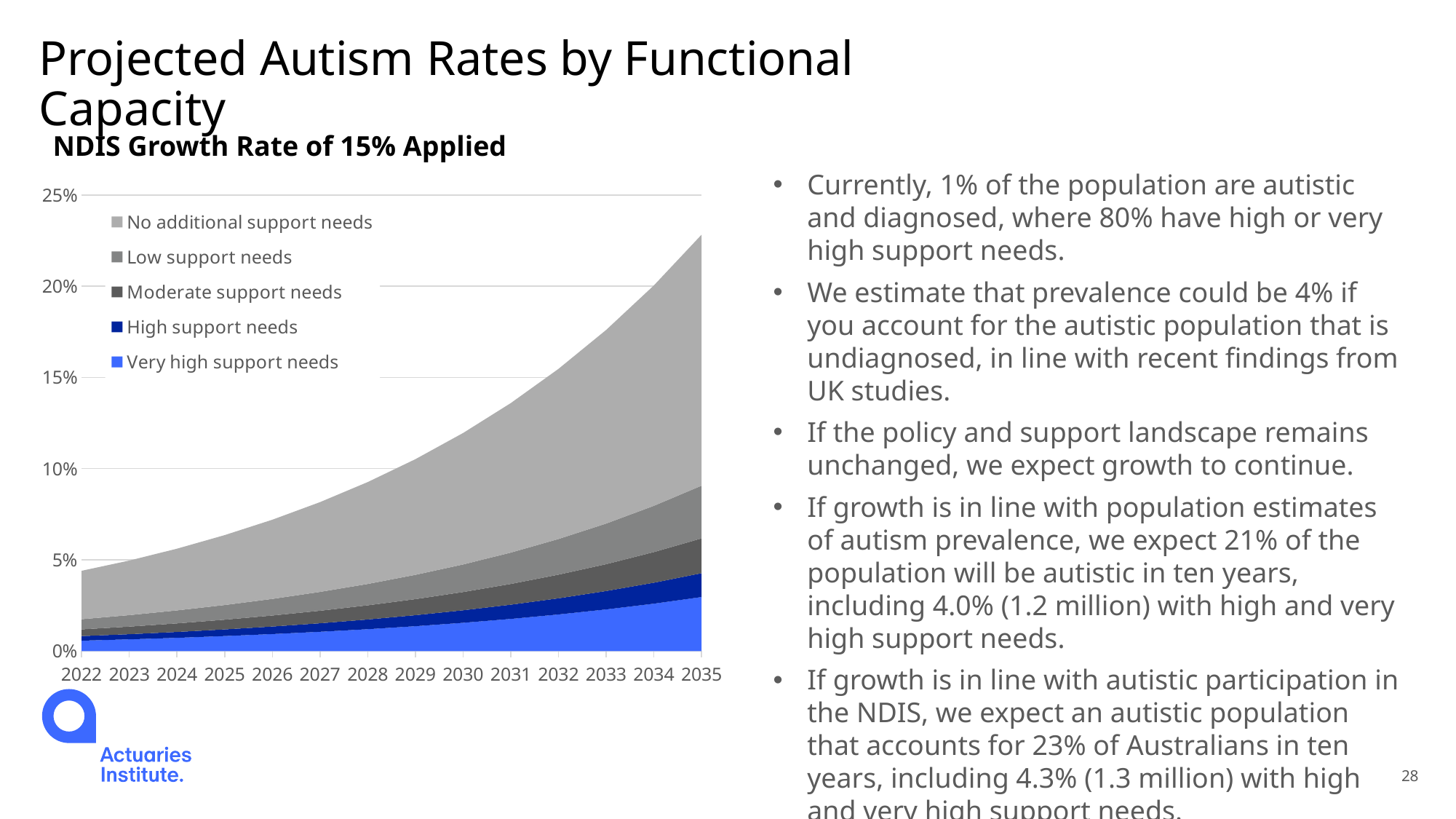
How many years are shown along the x axis of the chart? 14 What is the title of the chart? NDIS Growth Rate of 15% Applied Which year has the lowest total projected autism rate? 2022 Do the total projected autism rates rise or fall from 2022 to 2035? Rise Which year has the highest total projected autism rate? 2035 Which series is shown in the lightest grey at the top of the stacked areas? No additional support needs What kind of chart is shown on the slide? Stacked area chart How many series does the chart's legend list? 5 Is the total projected rate in 2035 greater or less than 20%? greater Is the total projected rate in 2033 greater or less than 15%? greater Is the total projected rate in 2022 greater or less than 5%? less